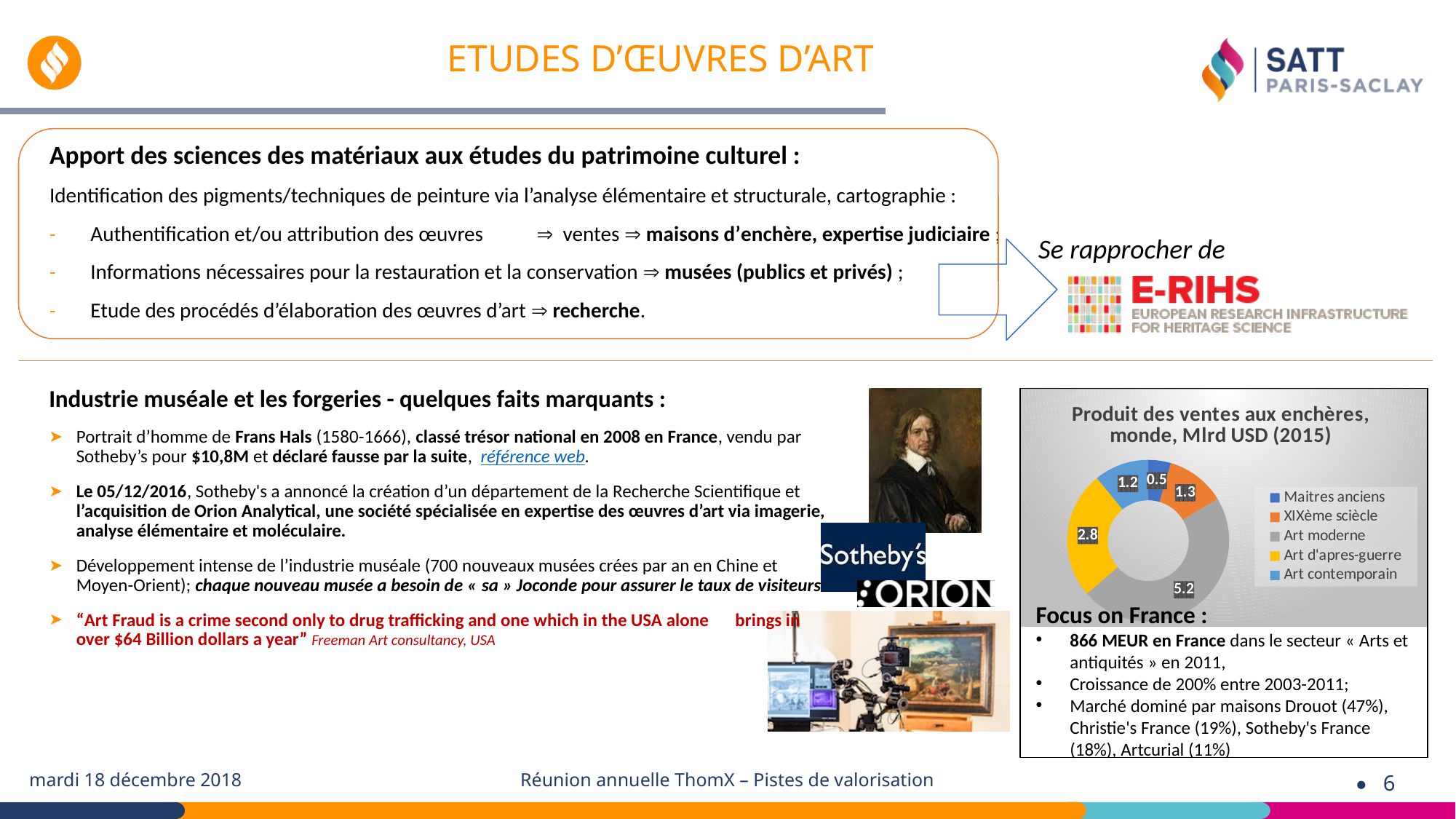
What is the value for Art contemporain in the chart? 1.2 What is the value for Art moderne in the chart? 5.2 What is the value for Maitres anciens in the chart? 0.5 Which category has the highest value in the chart? Art moderne What is the title of the chart on the slide? Produit des ventes aux enchères, monde, Mlrd USD (2015) What is the difference between the values for Art moderne and Art d'apres-guerre? 2.4 Which category has the lowest value in the chart? Maitres anciens What is the value for XIXème sciècle in the chart? 1.3 What is the value for Art d'apres-guerre in the chart? 2.8 Which is larger, the value for XIXème sciècle or the value for Art contemporain? XIXème sciècle What type of chart is shown on the slide? Doughnut (pie) chart How many categories does the chart's legend list? 5